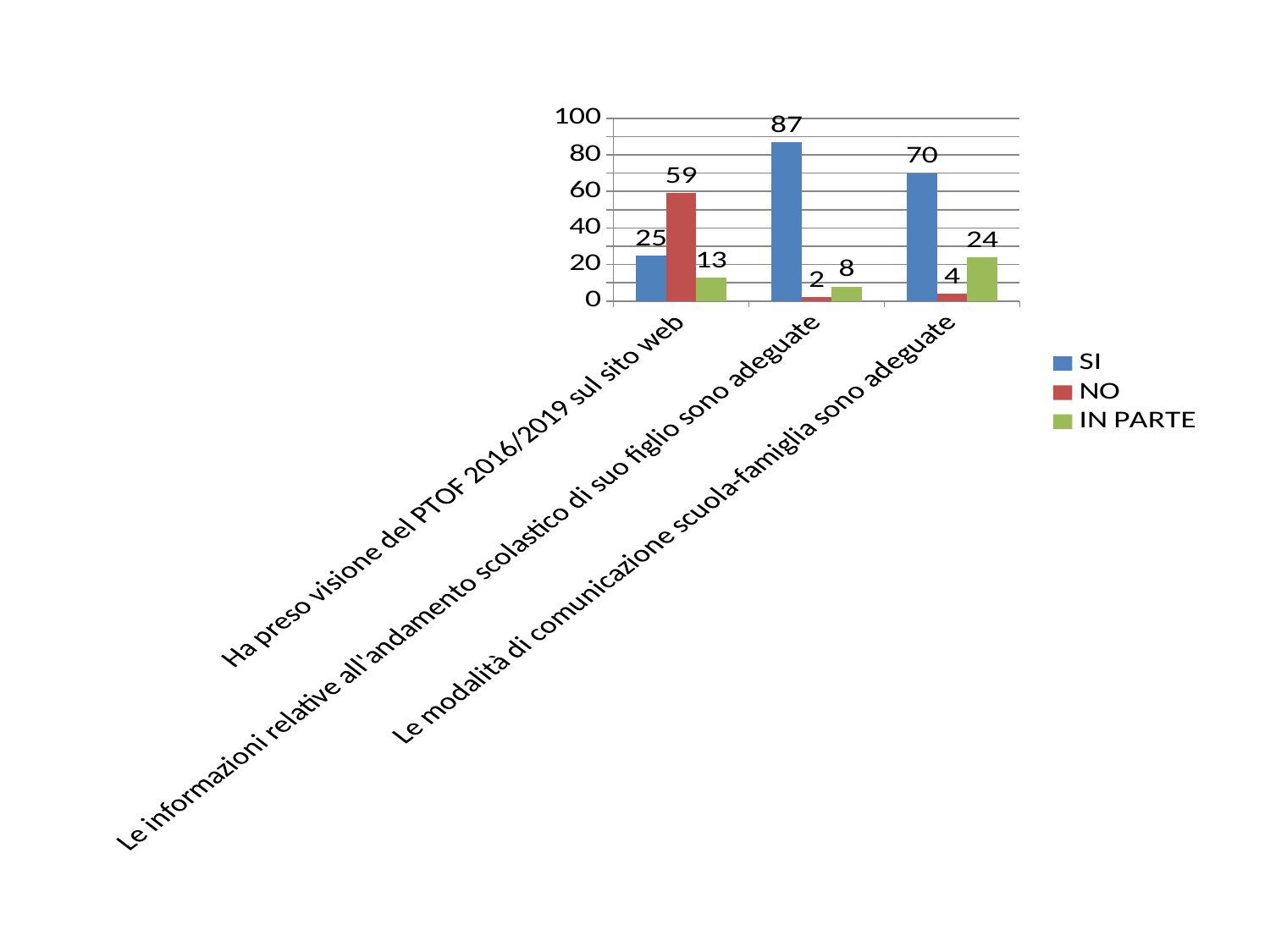
Which category has the lowest NO value? Le informazioni relative all'andamento scolastico di suo figlio sono adeguate What is the SI value for "Ha preso visione del PTOF 2016/2019 sul sito web"? 25 How many categories are shown on the x axis? 3 Which category has the highest SI value? Le informazioni relative all'andamento scolastico di suo figlio sono adeguate How many series does the legend list? 3 What kind of chart is shown on the slide? Bar chart Which is larger for "Le modalità di comunicazione scuola-famiglia sono adeguate": the SI value or the IN PARTE value? SI What is the IN PARTE value for "Le modalità di comunicazione scuola-famiglia sono adeguate"? 24 What is the NO value for "Ha preso visione del PTOF 2016/2019 sul sito web"? 59 What is the difference between the SI and NO values for "Ha preso visione del PTOF 2016/2019 sul sito web"? 34 What is the NO value for "Le informazioni relative all'andamento scolastico di suo figlio sono adeguate"? 2 What colour represents the NO series in the legend? Red